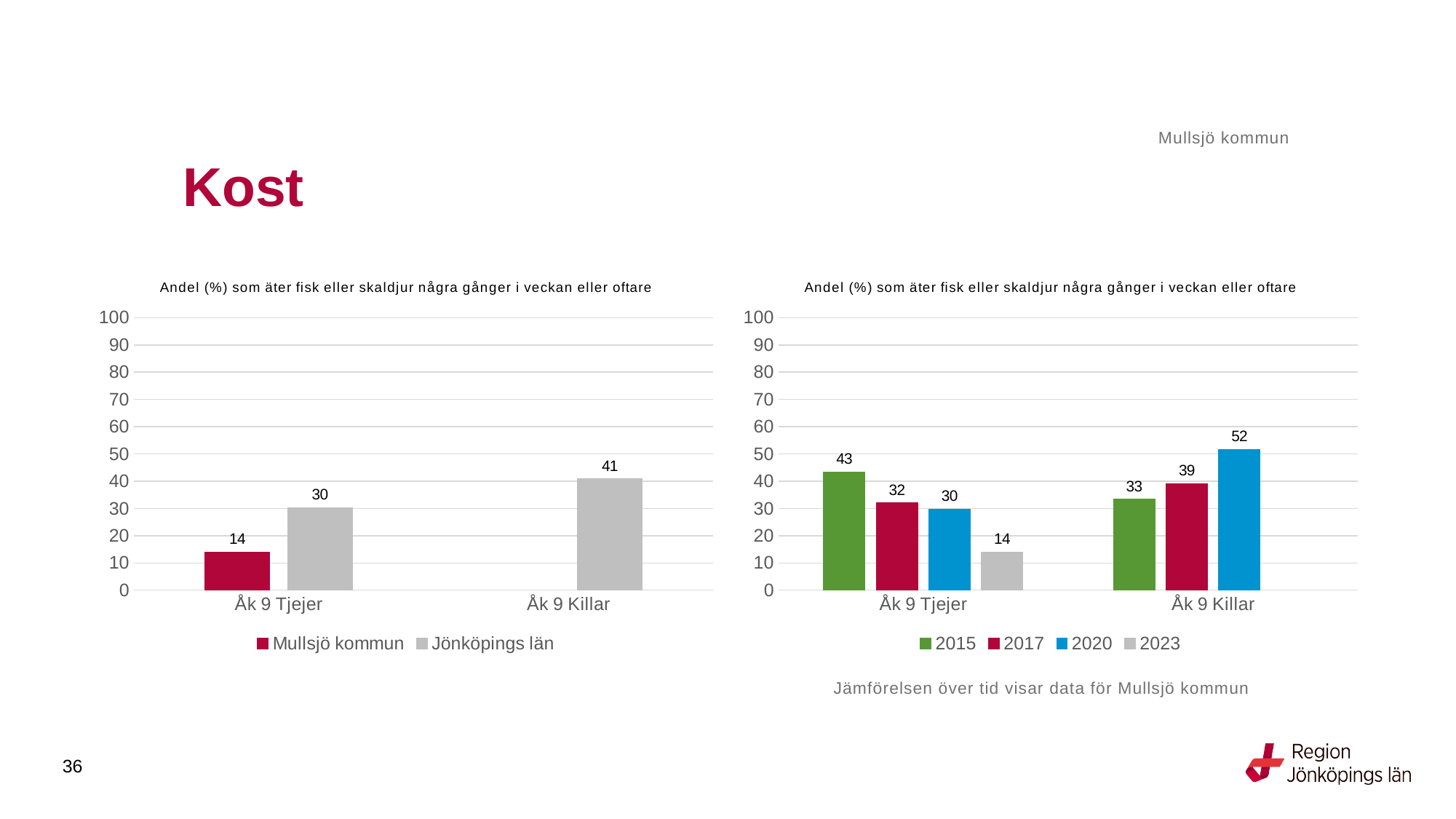
In the right chart, what is the difference between the 2020 and 2015 values for Åk 9 Killar? 19 In the right chart, which year has the highest value for Åk 9 Tjejer? 2015 In the left chart, what is the value for Mullsjö kommun for Åk 9 Tjejer? 14 In the right chart, what is the value for 2020 for Åk 9 Killar? 52 In the left chart, how many series does the legend list? 2 In the right chart, which is larger for 2017: Åk 9 Tjejer or Åk 9 Killar? Åk 9 Killar In the right chart, how many series does the legend list? 4 In the left chart, what is the value for Jönköpings län for Åk 9 Killar? 41 In the right chart, what is the value for 2023 for Åk 9 Tjejer? 14 What kind of chart is the right chart? Bar chart In the right chart, which year has the lowest value for Åk 9 Killar? 2015 In the left chart, what is the difference between Jönköpings län and Mullsjö kommun for Åk 9 Tjejer? 16